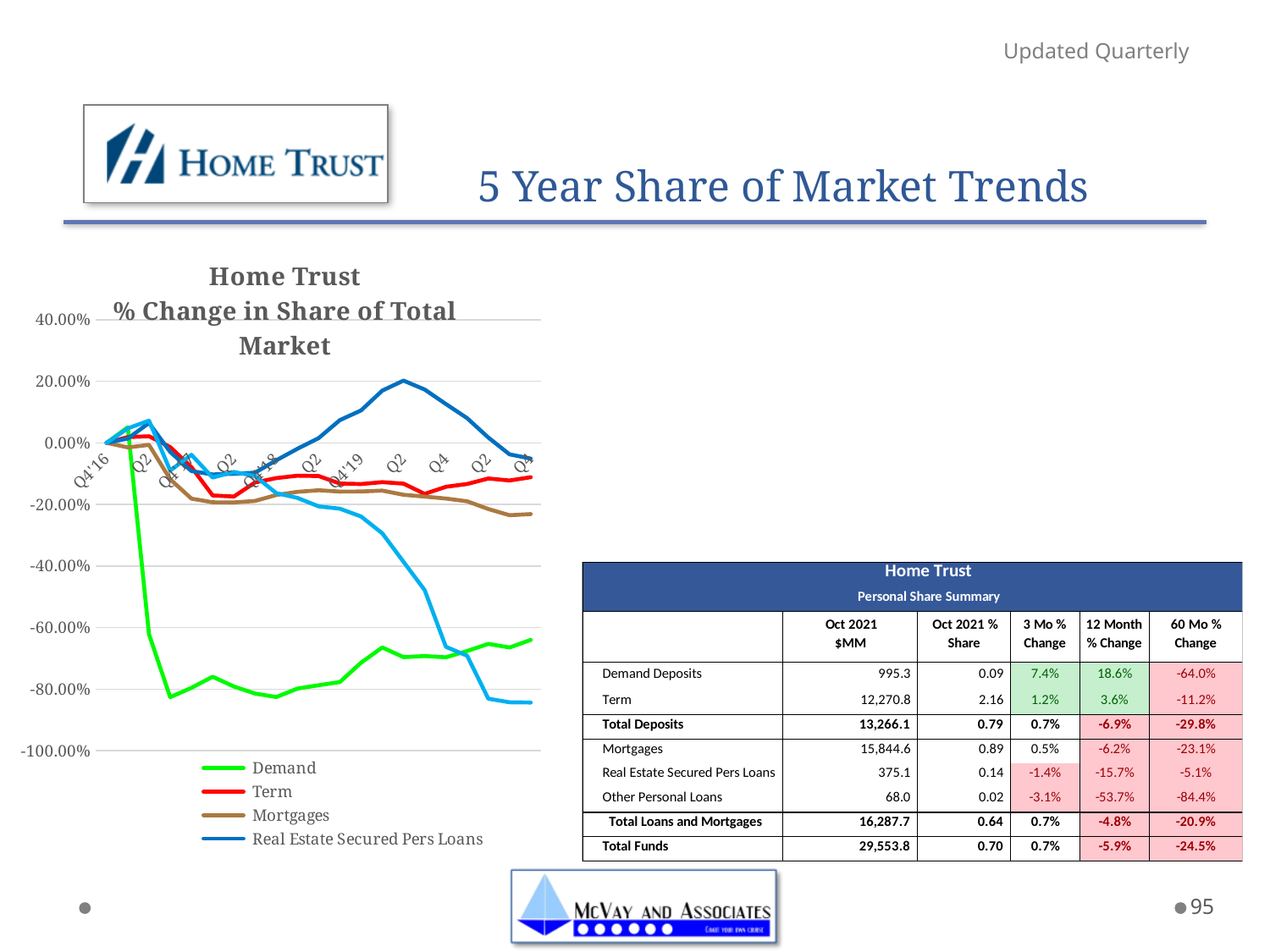
What is the title of the chart? Home Trust % Change in Share of Total Market Which series drops to the lowest value in the early part of the chart (around Q4 2017)? Demand At the final point on the chart, which is higher: Term or Mortgages? Term At its peak around Q2 2020, is the Real Estate Secured Pers Loans value greater or less than 0.00%? greater Which colour is used for the Demand series in the chart? Green Which series reaches the highest value on the chart? Real Estate Secured Pers Loans At the final point on the chart, is the Term value greater or less than -20.00%? greater How many series does the chart legend list? 4 At the final point on the chart, is the Demand value greater or less than -40.00%? less Does the Demand line end higher or lower than where it starts at Q4'16? Lower What kind of chart is shown on the slide? Line chart